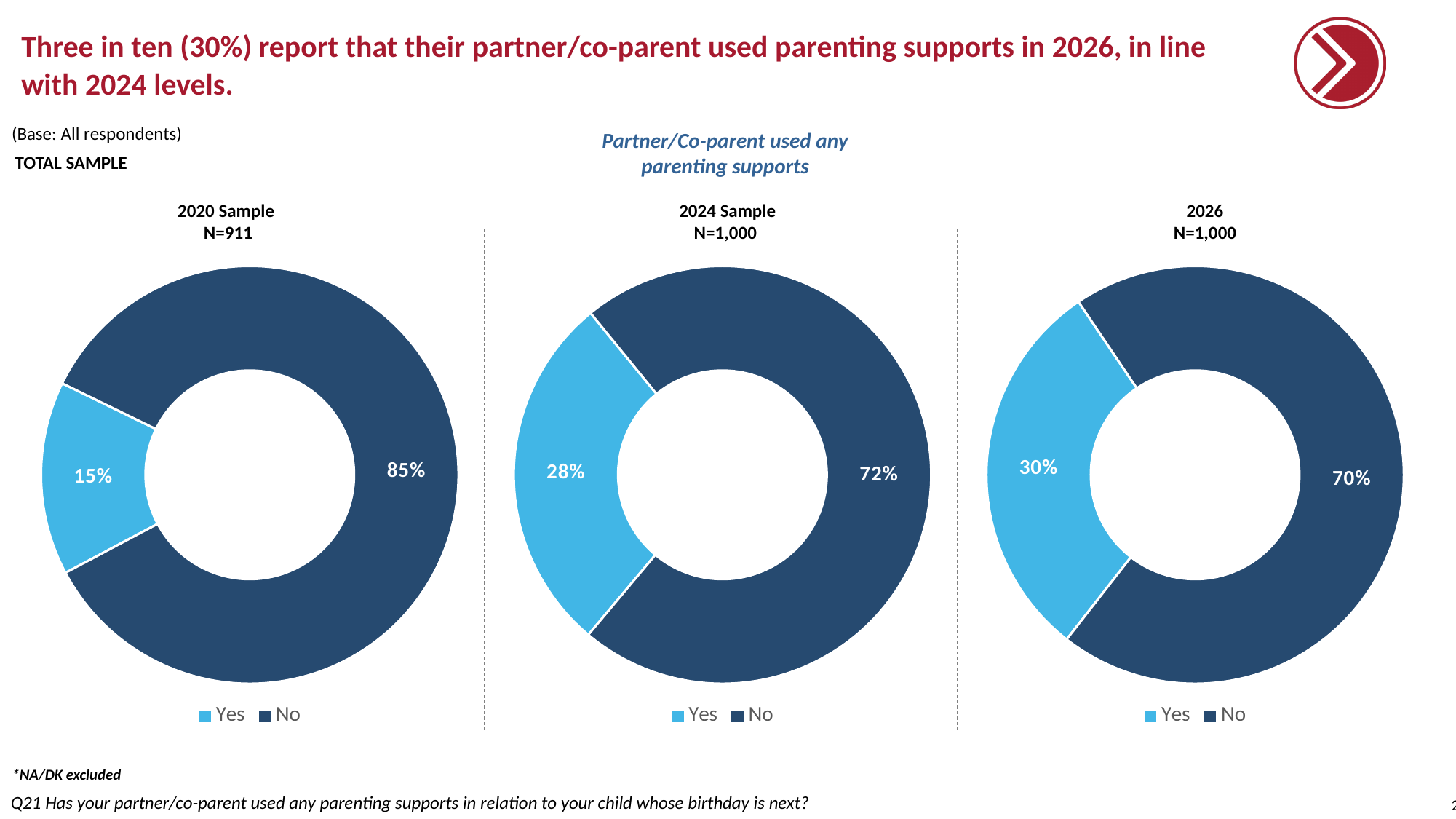
Which is larger: the Yes share in the 2024 Sample chart or the Yes share in the 2026 chart? 2026 Across the three charts from 2020 to 2026, does the Yes share rise or fall? Rise In the 2026 chart, what percentage answered Yes? 30% What is the difference between the Yes share in the 2026 chart and the Yes share in the 2020 Sample chart? 15 percentage points In the 2024 Sample chart, which category has the smallest share? Yes In the 2026 chart, what percentage answered No? 70% In the 2024 Sample chart, what percentage answered No? 72% In the 2020 Sample chart, what percentage answered Yes? 15% What kind of chart is used for the 2026 data? Doughnut chart In the 2020 Sample chart, which category has the largest share? No How many categories does the legend of the 2020 Sample chart list? 2 What is the sample size (N) shown for the 2020 Sample chart? N=911